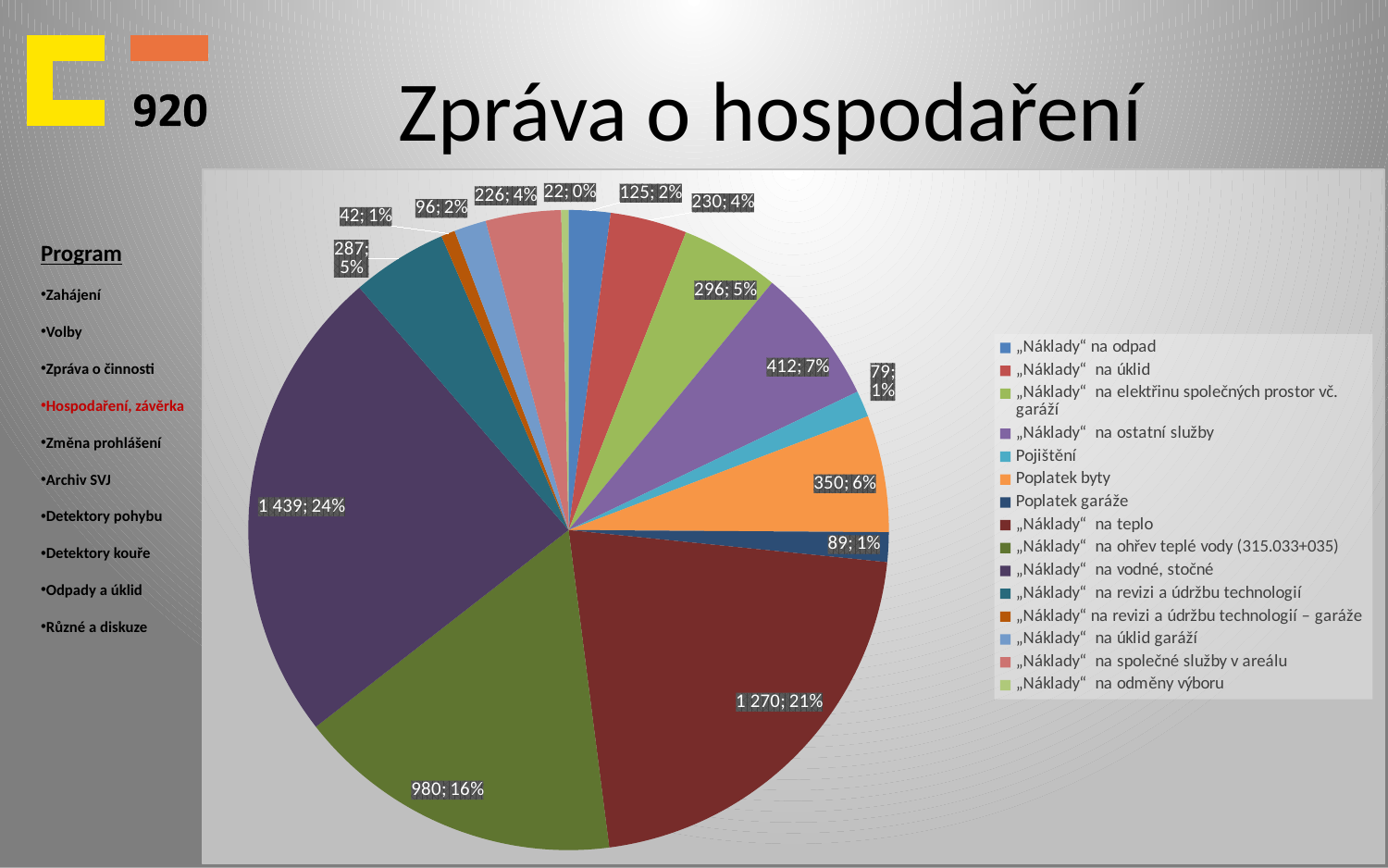
Which category has the largest slice of the pie? „Náklady" na vodné, stočné What value is shown for Poplatek byty? 350; 6% What value is shown for Pojištění? 79; 1% What value is shown for „Náklady" na vodné, stočné? 1 439; 24% What is the difference between the values for „Náklady" na vodné, stočné and „Náklady" na teplo? 169 What kind of chart is shown on the slide? pie chart What colour is the slice for „Náklady" na teplo? dark red What value is shown for „Náklady" na teplo? 1 270; 21% What share of the pie does „Náklady" na ohřev teplé vody (315.033+035) represent? 16% How many entries does the legend of the pie chart list? 15 Which category has the smallest slice of the pie? „Náklady" na odměny výboru Which is larger, the value for „Náklady" na ostatní služby or the value for Poplatek byty? „Náklady" na ostatní služby